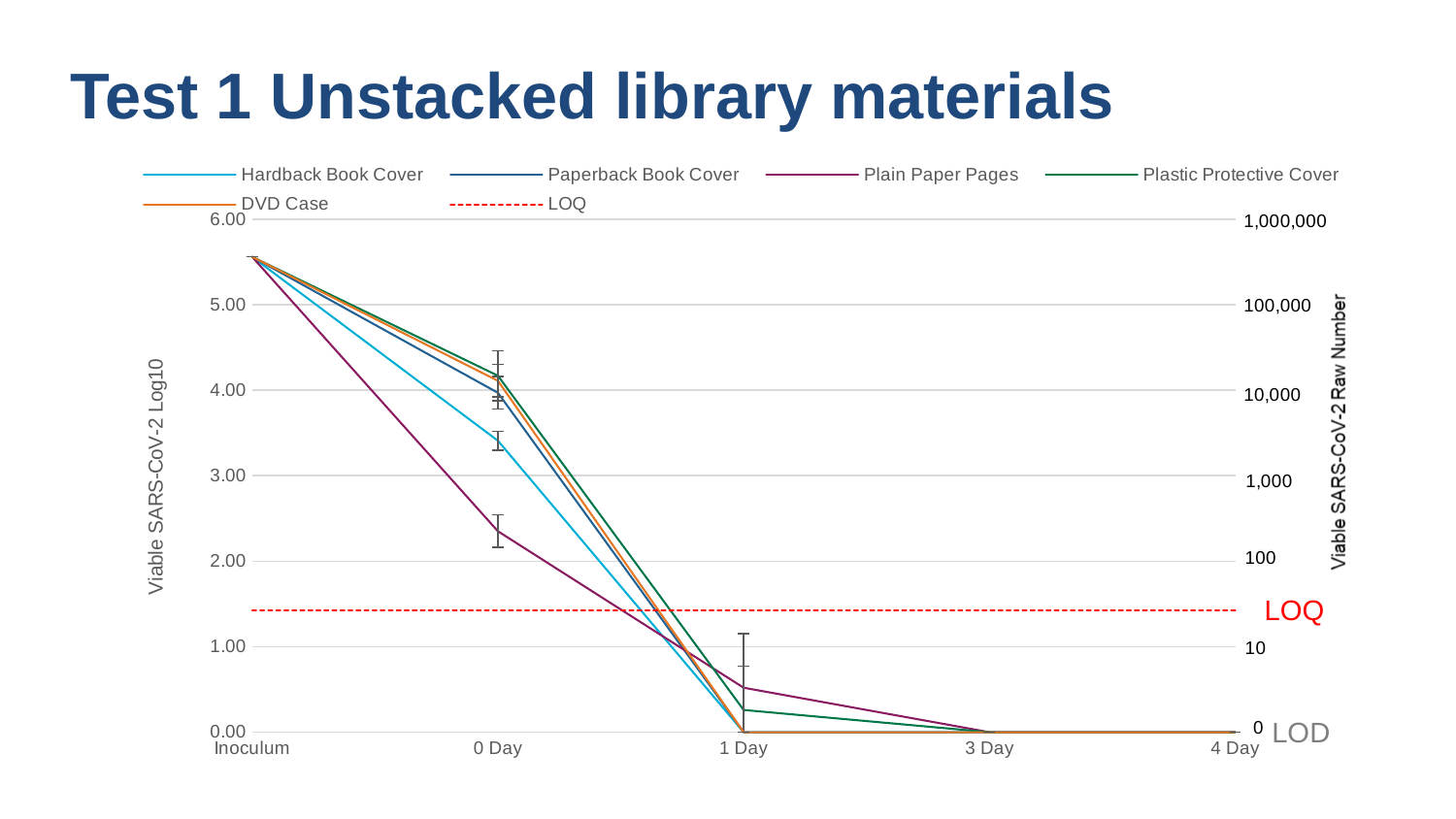
At 0 Day, which is larger: the value for Hardback Book Cover or the value for Plain Paper Pages? Hardback Book Cover Do the values for Hardback Book Cover rise or fall from Inoculum to 4 Day? fall How many time points are shown along the x axis? 5 How many entries does the chart legend list? 6 Is the value for Plain Paper Pages at 0 Day greater or less than 3.00? less What is the value for DVD Case at 4 Day on the left axis? 0.00 Is the value for Plastic Protective Cover at 0 Day greater or less than 4.00? greater Is the value for DVD Case at Inoculum greater or less than 5.00? greater What kind of chart is shown on the slide? line chart What is the title of the slide? Test 1 Unstacked library materials Which material has the lowest value at 0 Day? Plain Paper Pages